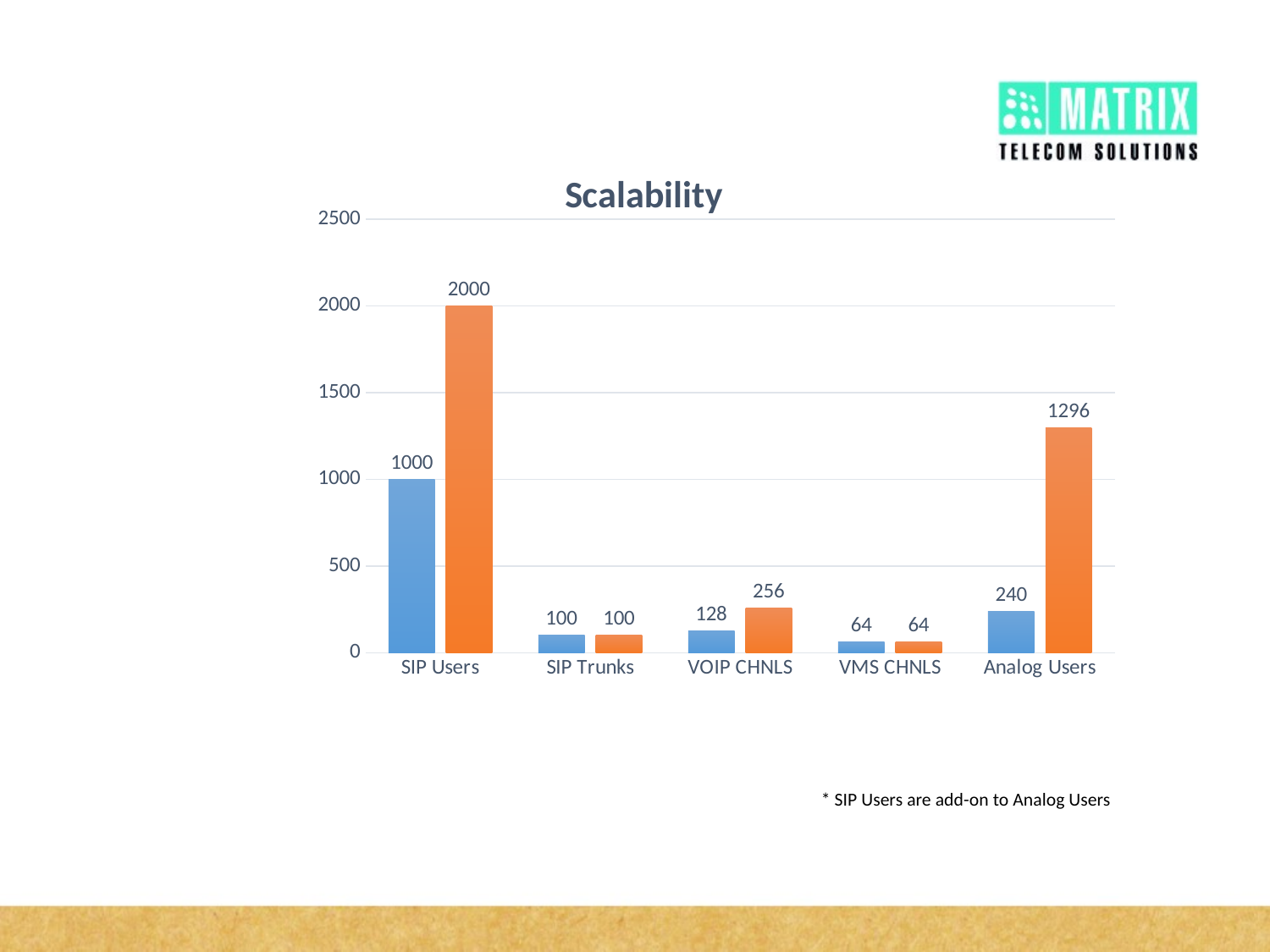
What is the value of the blue bar for Analog Users? 240 What is the value of the orange bar for SIP Users? 2000 What is the title of the chart? Scalability Which category has the highest orange bar? SIP Users How many categories are shown on the x axis of the Scalability chart? 5 What kind of chart is shown on the slide? bar chart What is the difference between the orange and blue bars for Analog Users? 1056 Is the orange bar for Analog Users greater or less than 1500? less What is the value of the orange bar for VOIP CHNLS? 256 Which category has the lowest blue bar? VMS CHNLS What is the difference between the orange and blue bars for SIP Users? 1000 Which is larger: the orange bar for Analog Users or the blue bar for SIP Users? the orange bar for Analog Users